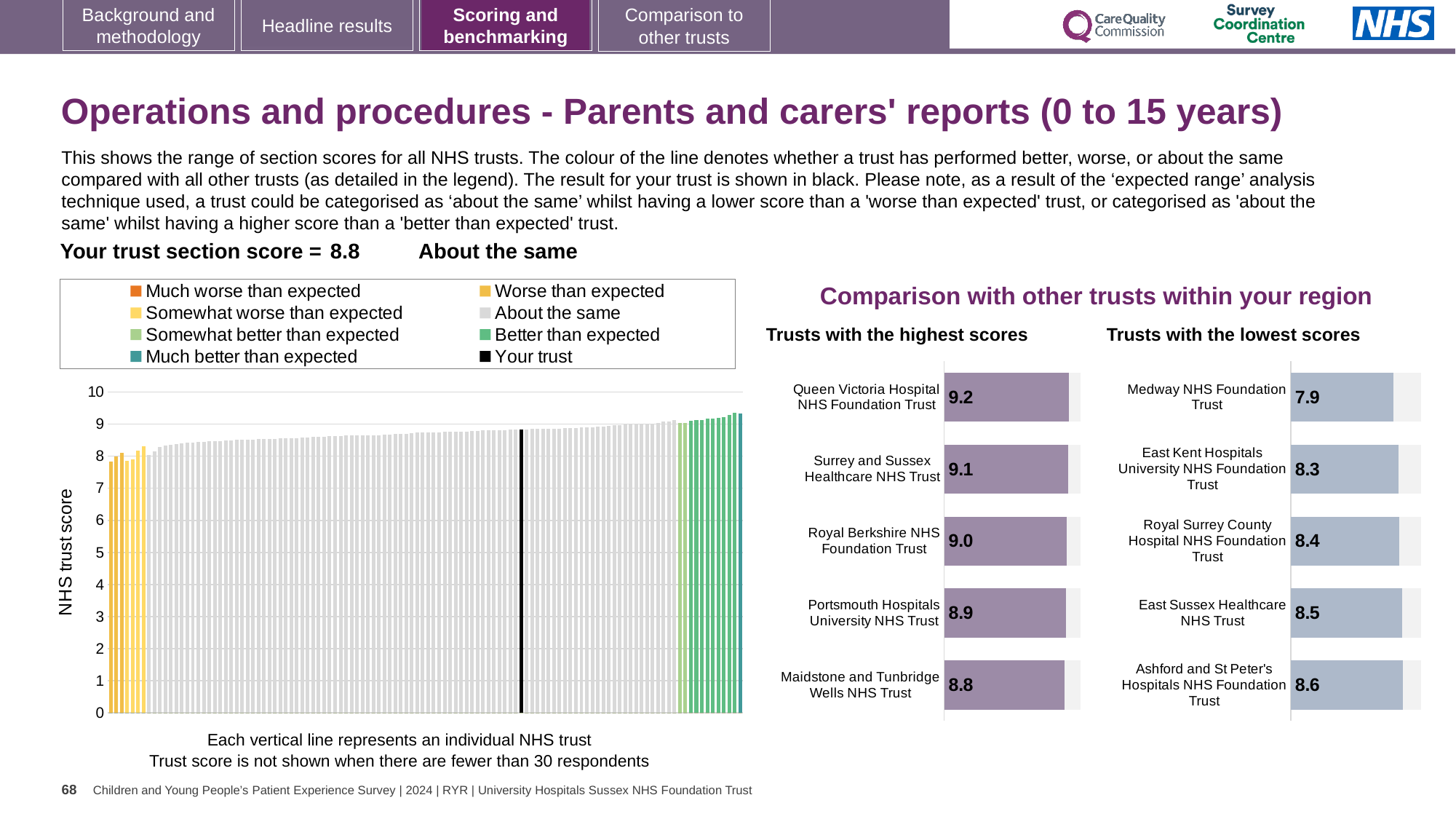
In the 'NHS trust score' chart on the left, do the values rise or fall from left to right along the x axis? Rise In the 'Trusts with the highest scores' chart, what is the score for Royal Berkshire NHS Foundation Trust? 9.0 In the 'Trusts with the lowest scores' chart, which trust has the lowest score? Medway NHS Foundation Trust In the 'Trusts with the highest scores' chart, what is the difference between the scores of Queen Victoria Hospital NHS Foundation Trust and Maidstone and Tunbridge Wells NHS Trust? 0.4 In the 'Trusts with the lowest scores' chart, what is the difference between the scores of Ashford and St Peter's Hospitals NHS Foundation Trust and Medway NHS Foundation Trust? 0.7 In the 'Trusts with the highest scores' chart, what is the score for Queen Victoria Hospital NHS Foundation Trust? 9.2 In the 'Trusts with the lowest scores' chart, what is the score for Medway NHS Foundation Trust? 7.9 In the 'Trusts with the lowest scores' chart, which has the higher score: East Kent Hospitals University NHS Foundation Trust or East Sussex Healthcare NHS Trust? East Sussex Healthcare NHS Trust How many trusts are listed in the 'Trusts with the highest scores' chart? 5 How many entries does the legend above the 'NHS trust score' chart list? 8 What kind of chart is the 'NHS trust score' chart on the left of the slide? Bar chart In the 'Trusts with the highest scores' chart, which trust has the highest score? Queen Victoria Hospital NHS Foundation Trust